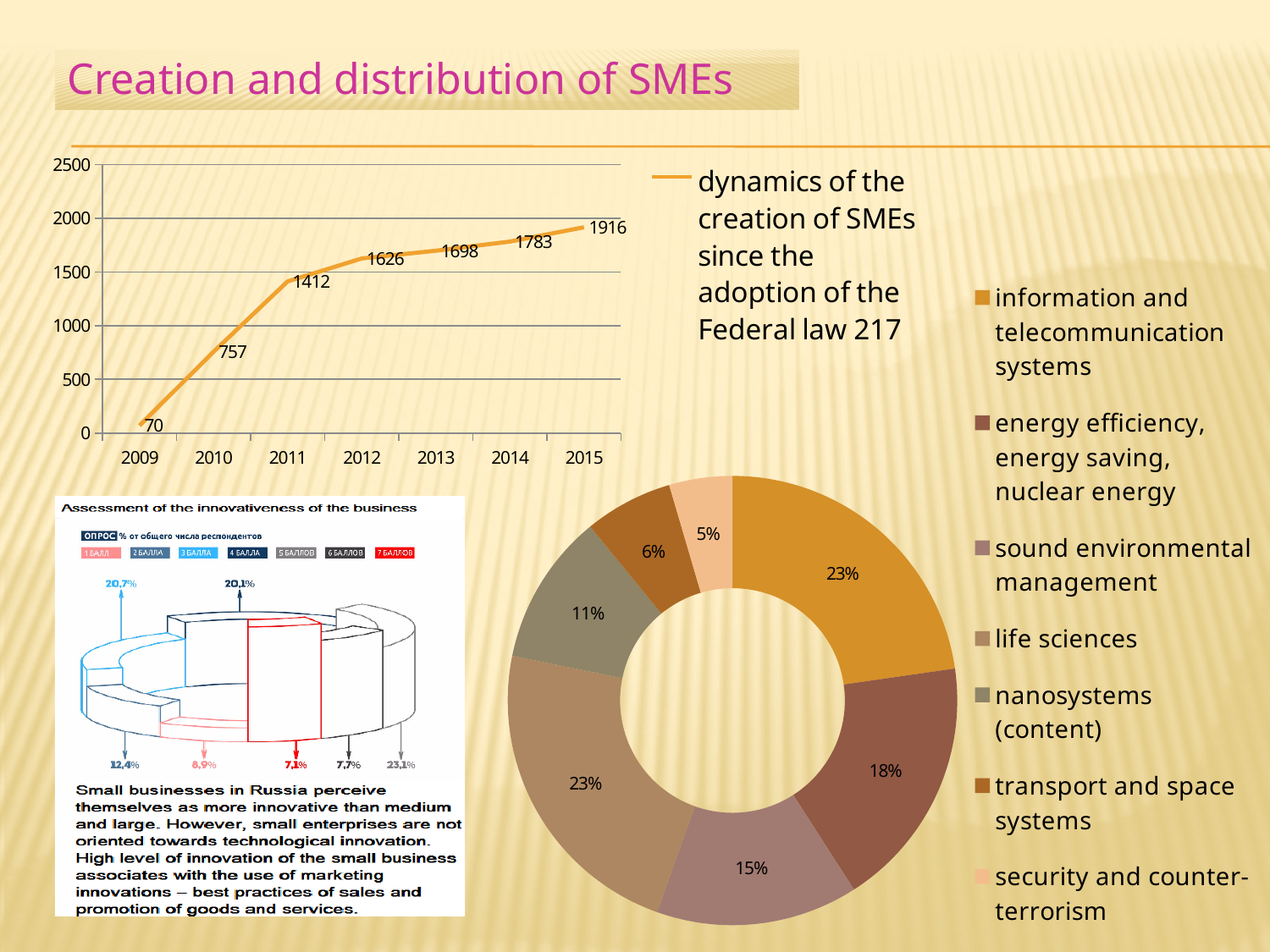
What kind of chart is the chart at the top left of the slide? line chart In the doughnut chart at the bottom right, which is larger: sound environmental management or nanosystems (content)? sound environmental management How many categories does the legend of the doughnut chart at the bottom right list? 7 In the line chart at the top left, what value is shown for 2011? 1412 In the line chart at the top left, how many years are plotted on the x axis? 7 In the line chart at the top left, what is the difference between the values for 2010 and 2009? 687 In the line chart at the top left, what value is shown for 2009? 70 In the doughnut chart at the bottom right, what share is shown for energy efficiency, energy saving, nuclear energy? 18% In the line chart at the top left, what value is shown for 2015? 1916 In the line chart at the top left, do the values rise or fall from 2009 to 2015? rise In the doughnut chart at the bottom right, which category has the smallest share? security and counter-terrorism In the line chart at the top left, which year has the highest value? 2015